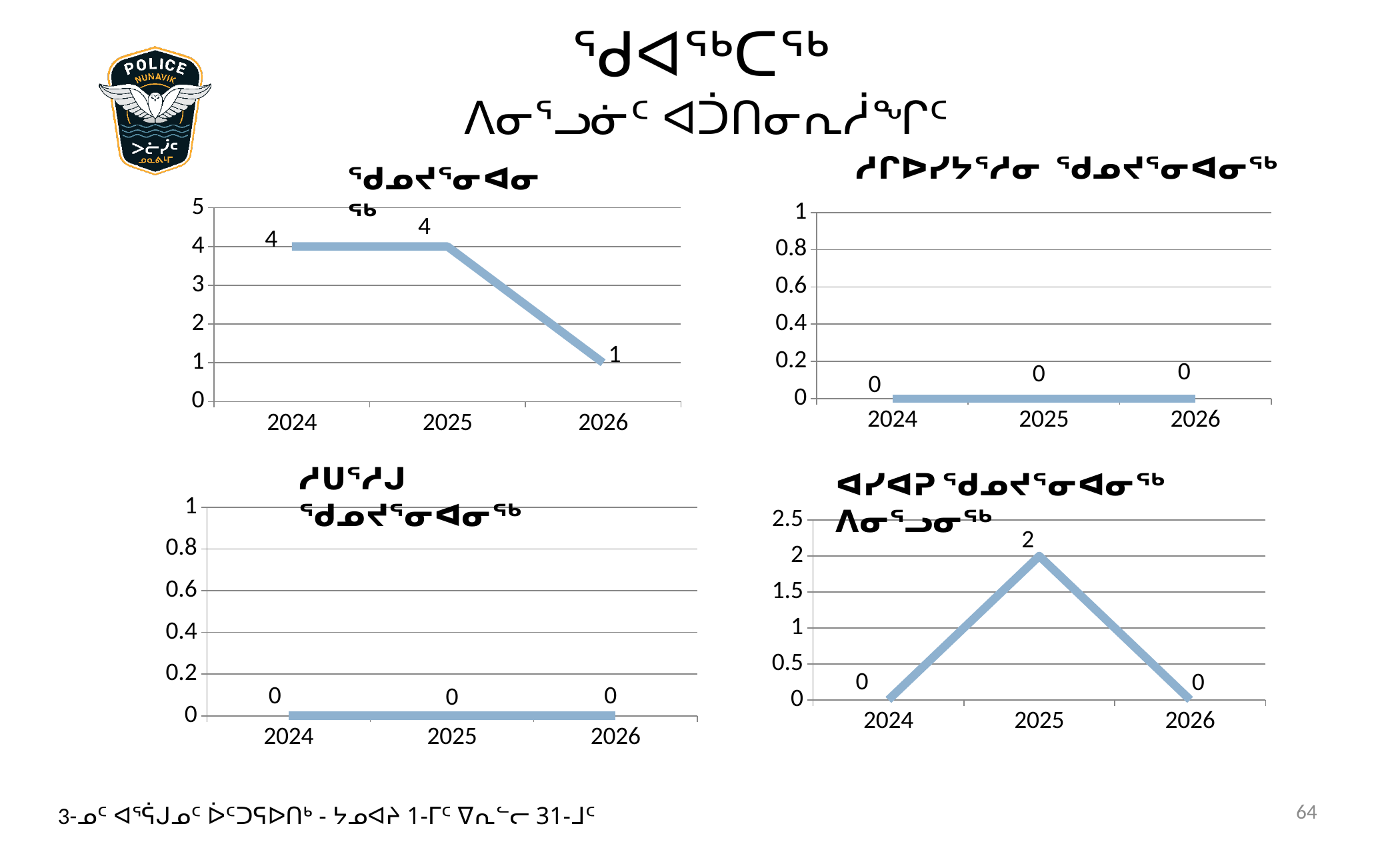
In the bottom-right chart, is the value for 2025 larger than the value for 2026? Yes In the bottom-right chart, which year has the highest value? 2025 In the bottom-right chart, what is the value for 2025? 2 How many years are plotted in the top-right chart? 3 In the top-left chart, what is the value for 2024? 4 In the top-left chart, what is the value for 2026? 1 What kind of chart is the bottom-right chart? line chart In the top-left chart, what is the difference between the values for 2025 and 2026? 3 In the top-left chart, do the values rise or fall from 2025 to 2026? fall In the bottom-left chart, what is the value for 2026? 0 In the top-left chart, which year has the lowest value? 2026 In the top-right chart, what is the value for 2025? 0